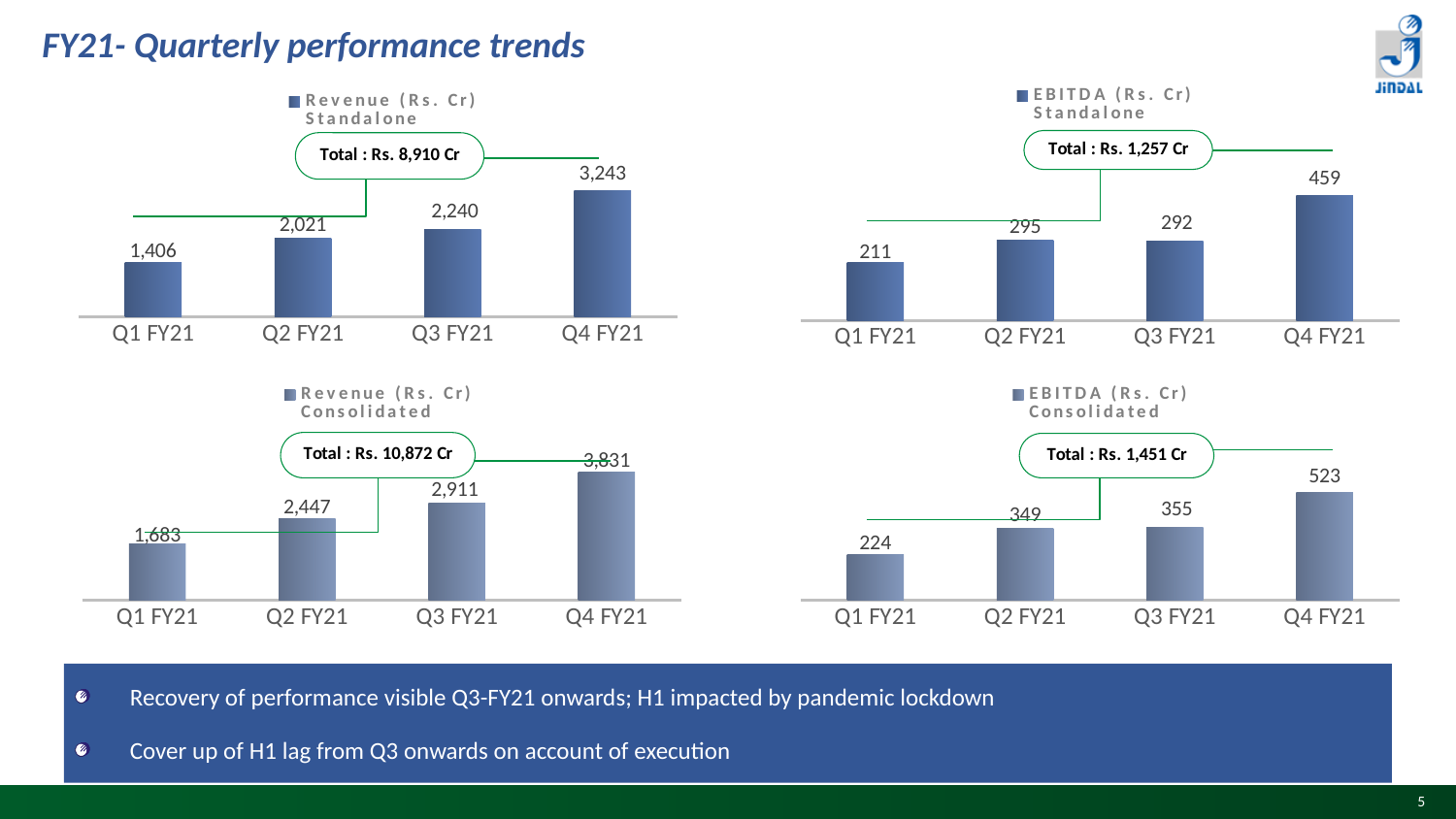
In the EBITDA (Rs. Cr) Consolidated chart, which is larger, Q4 FY21 or Q1 FY21? Q4 FY21 In the EBITDA (Rs. Cr) Standalone chart, which quarter has the highest EBITDA? Q4 FY21 In the Revenue (Rs. Cr) Standalone chart, what is the value for Q4 FY21? 3,243 What total is shown in the callout on the Revenue (Rs. Cr) Consolidated chart? Total : Rs. 10,872 Cr In the EBITDA (Rs. Cr) Consolidated chart, what is the value for Q2 FY21? 349 How many quarters are shown in the Revenue (Rs. Cr) Consolidated chart? 4 What kind of chart is the EBITDA (Rs. Cr) Standalone chart? Bar chart In the Revenue (Rs. Cr) Consolidated chart, what is the value for Q3 FY21? 2,911 In the Revenue (Rs. Cr) Consolidated chart, what is the difference between Q2 FY21 and Q1 FY21? 764 In the Revenue (Rs. Cr) Standalone chart, which quarter has the lowest revenue? Q1 FY21 In the Revenue (Rs. Cr) Standalone chart, what is the difference between Q4 FY21 and Q1 FY21? 1,837 In the EBITDA (Rs. Cr) Standalone chart, what is the value for Q1 FY21? 211